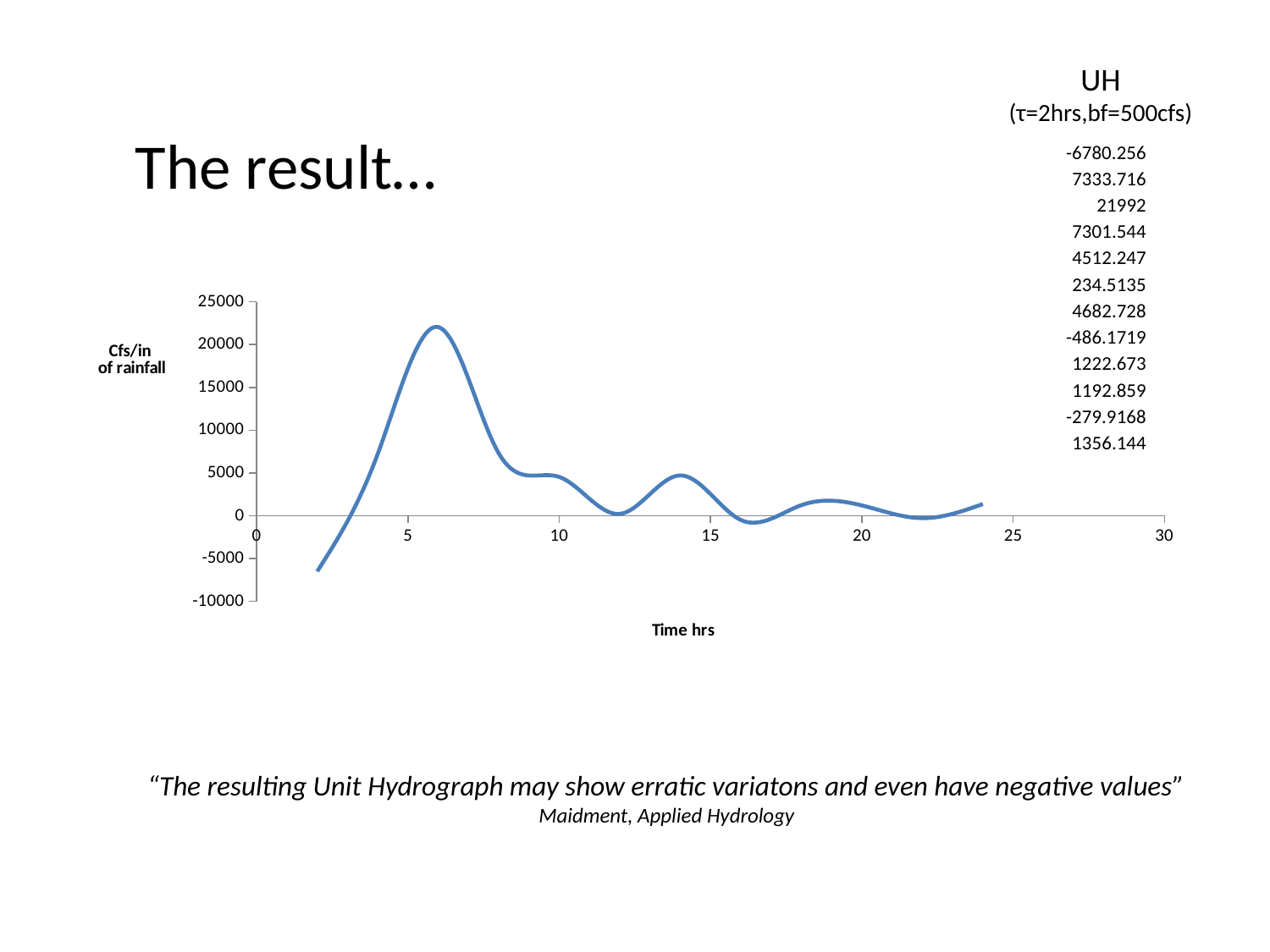
Is the value of the curve at 14 hrs greater or less than 10000? less Is the lowest value of the curve greater or less than -5000? less What is the highest value shown on the y axis of the chart? 25000 Is the value of the curve at 6 hrs greater or less than 20000? greater Which is larger, the value of the curve at 6 hrs or at 14 hrs? 6 hrs What kind of chart is shown on the slide? line chart What is the title of the x axis of the chart? Time hrs Does the curve reach its highest value before or after 10 hrs? before Between 2 hrs and 6 hrs, does the curve rise or fall? rise Between 6 hrs and 9 hrs, does the curve rise or fall? fall